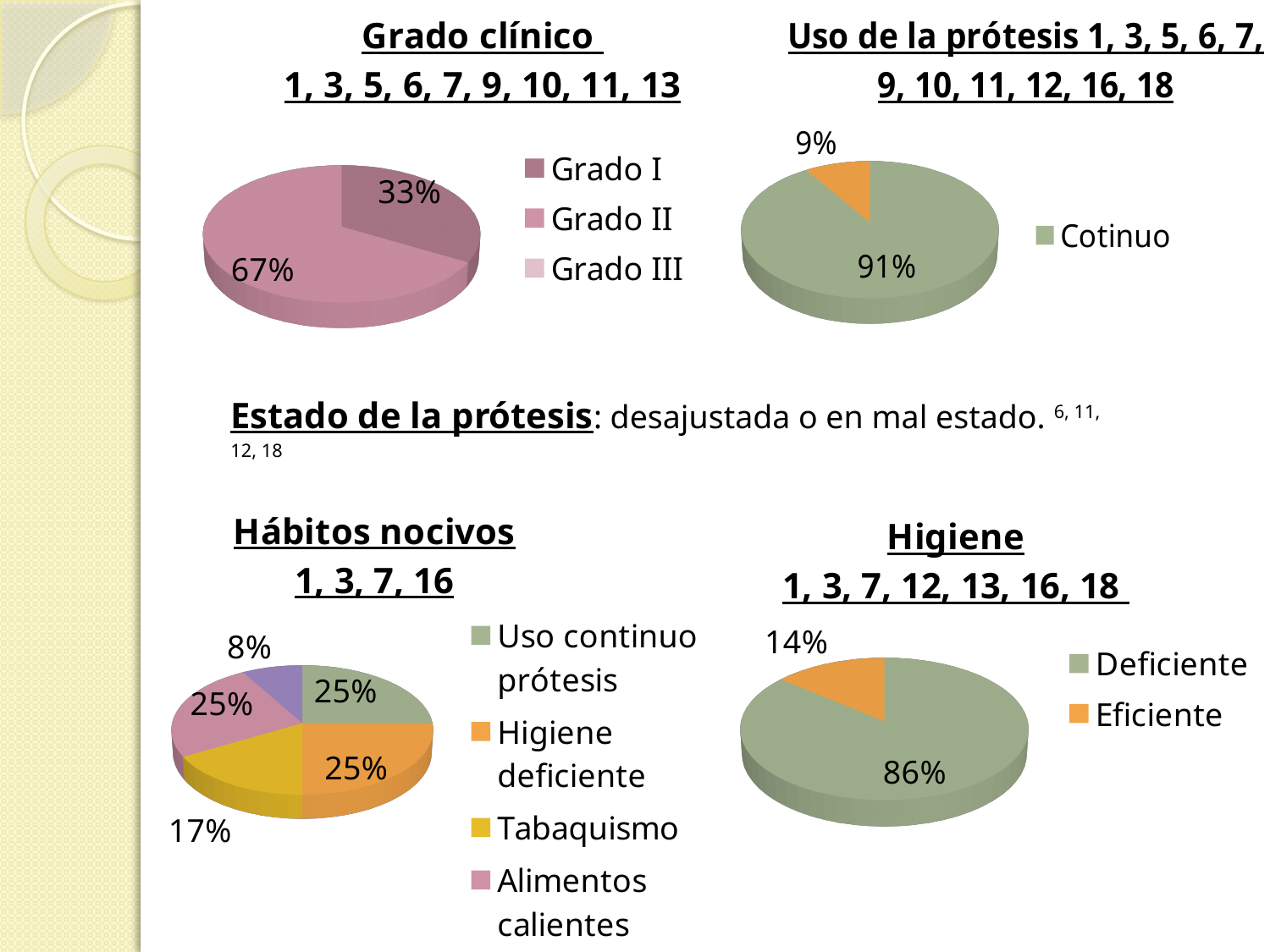
In the 'Hábitos nocivos' pie chart, which is larger, the Higiene deficiente slice or the Tabaquismo slice? Higiene deficiente In the 'Grado clínico' pie chart, how many entries does the legend list? 3 In the 'Higiene' pie chart, which category has the smaller share, Deficiente or Eficiente? Eficiente In the 'Higiene' pie chart, what percentage is shown for Deficiente? 86% What kind of chart is used for 'Higiene'? Pie chart In the 'Hábitos nocivos' pie chart, what percentage is shown for Tabaquismo? 17% In the 'Grado clínico' pie chart, what is the difference between the Grado II and Grado I percentages? 34% In the 'Hábitos nocivos' pie chart, how many entries does the legend list? 4 In the 'Grado clínico' pie chart, what percentage is shown for Grado II? 67% In the 'Uso de la prótesis' pie chart, what percentage is labelled for the Cotinuo slice? 91% In the 'Grado clínico' pie chart, what percentage is shown for Grado I? 33% In the 'Uso de la prótesis' pie chart, what percentage is shown on the smaller orange slice? 9%